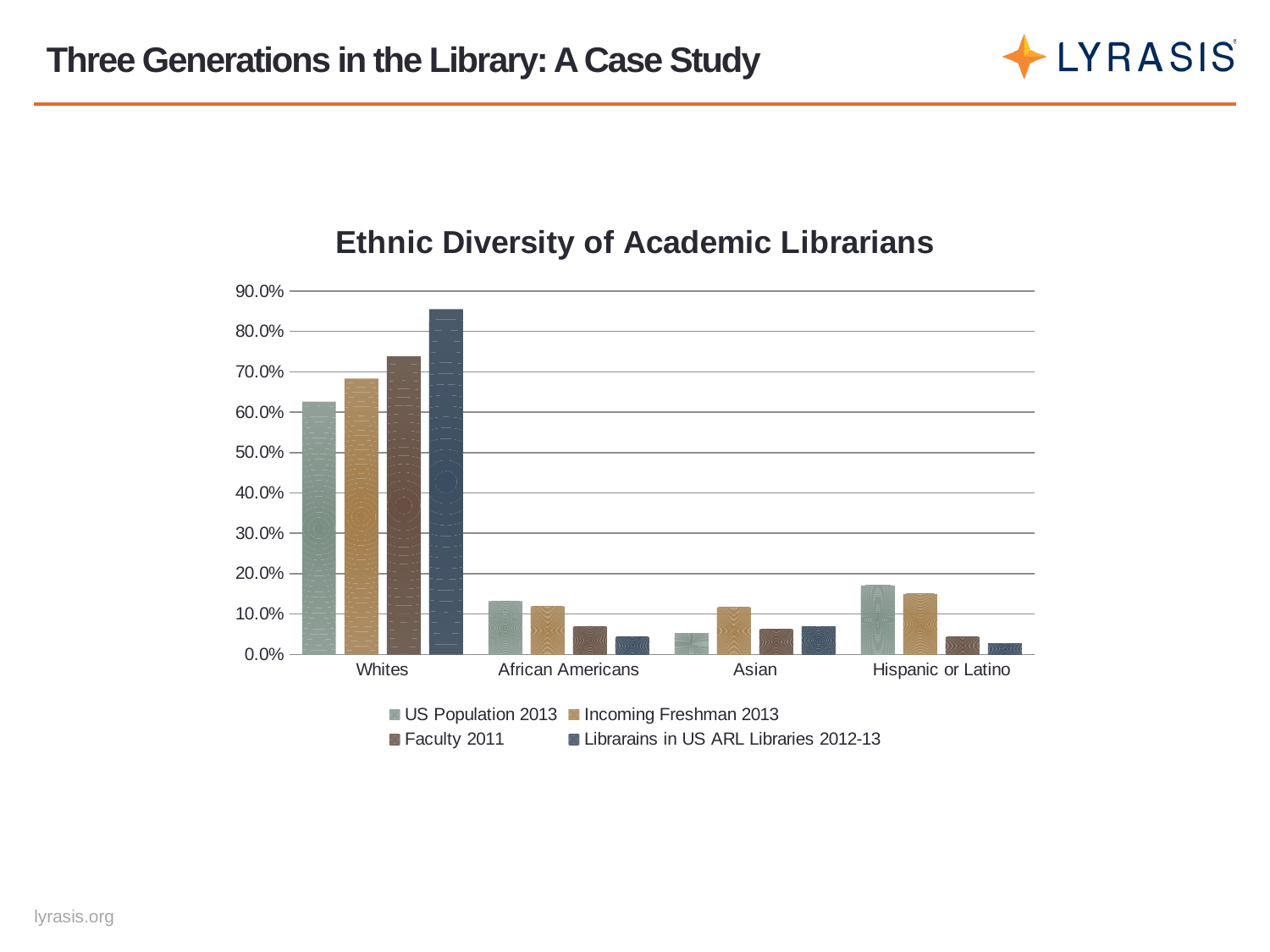
What is the title of the chart? Ethnic Diversity of Academic Librarians Is the value for US Population 2013 for Hispanic or Latino greater or less than 10.0%? greater Which series has the highest value for Whites? Librarains in US ARL Libraries 2012-13 How many ethnic categories are shown on the x axis? 4 Which series has the lowest value for Whites? US Population 2013 Is the value for Librarains in US ARL Libraries 2012-13 for Whites greater or less than 80.0%? greater For Hispanic or Latino, which is larger: Faculty 2011 or Librarains in US ARL Libraries 2012-13? Faculty 2011 Which category has the tallest bar in the whole chart? Whites Is the value for US Population 2013 for Whites greater or less than 70.0%? less How many series does the legend list? 4 What kind of chart is shown on the slide? bar chart For Asian, which is larger: US Population 2013 or Incoming Freshman 2013? Incoming Freshman 2013